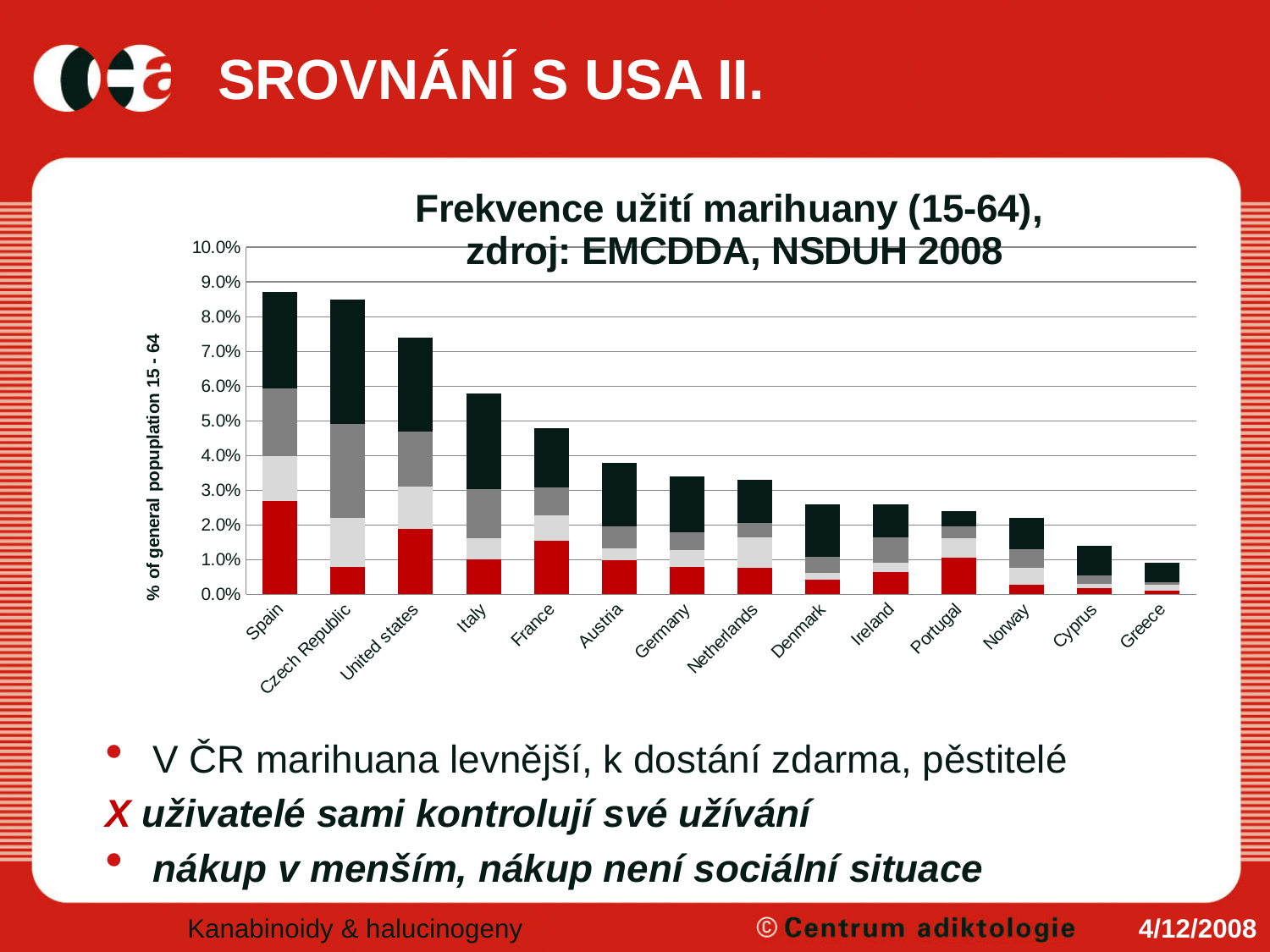
Is the total value for Spain greater or less than 8.0%? greater Is the total value for Germany greater or less than 4.0%? less What kind of chart is shown on the slide? Stacked bar chart Do the total bar heights rise or fall from left to right along the x axis? Fall What is the label on the vertical axis of the chart? % of general popuplation 15 - 64 Which country has the lowest total bar in the chart? Greece Which has the larger total bar, Spain or Italy? Spain Is the total value for Denmark greater or less than 3.0%? less Which has the larger total bar, Portugal or Norway? Portugal How many countries are shown on the x axis of the chart? 14